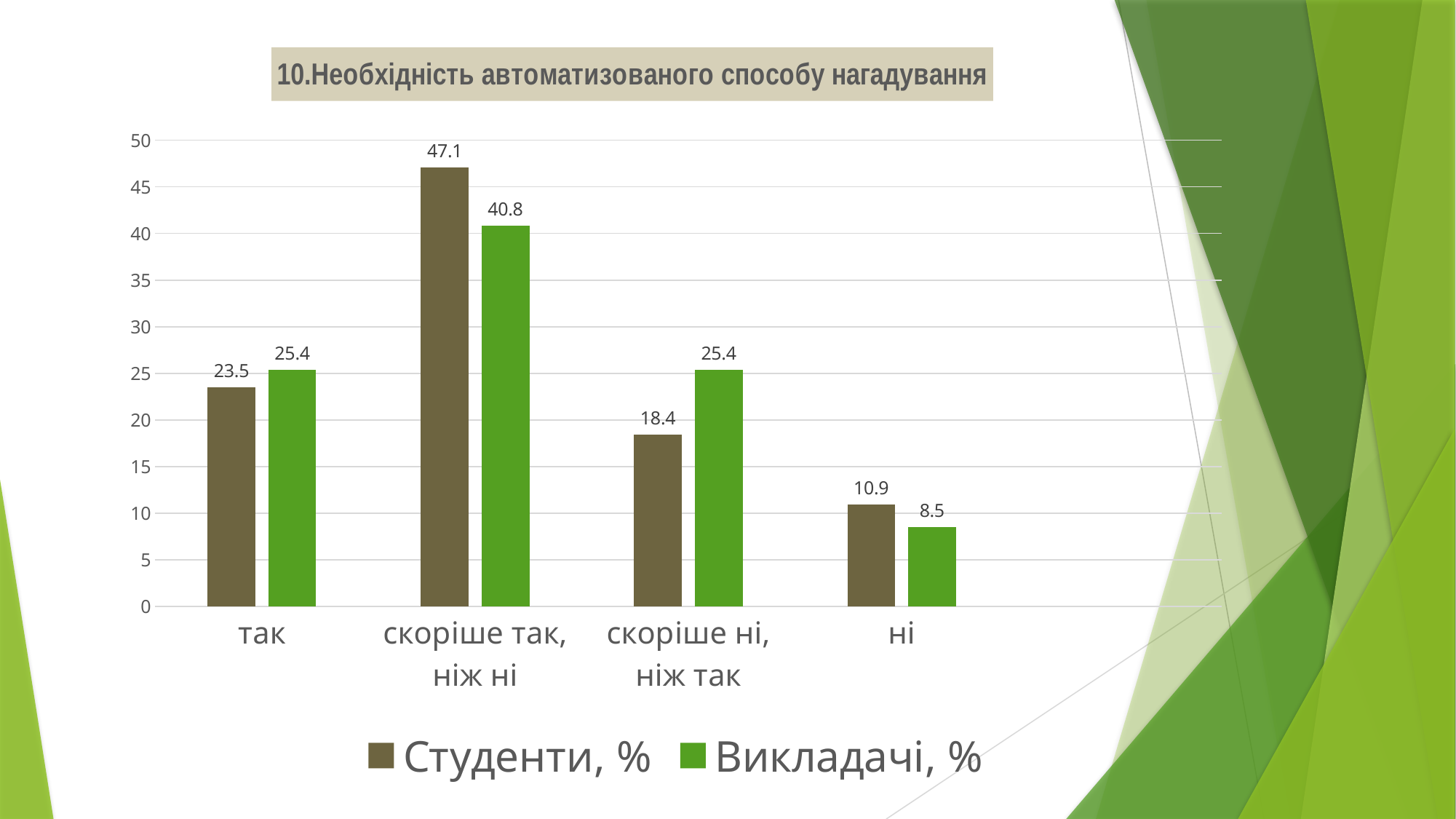
Is the value for Студенти, % in the category "скоріше так, ніж ні" greater or less than 45? greater What kind of chart is shown on the slide? bar chart What is the value for Студенти, % in the category "ні"? 10.9 Which category has the highest value for Студенти, %? скоріше так, ніж ні What is the title of the chart? 10.Необхідність автоматизованого способу нагадування What is the value for Студенти, % in the category "так"? 23.5 Which category has the lowest value for Викладачі, %? ні In the category "скоріше ні, ніж так", which series has the larger value, Студенти, % or Викладачі, %? Викладачі, % How many categories are shown on the x axis? 4 How many series does the legend list? 2 What is the value for Викладачі, % in the category "скоріше так, ніж ні"? 40.8 What is the difference between the Студенти, % and Викладачі, % values in the category "скоріше так, ніж ні"? 6.3